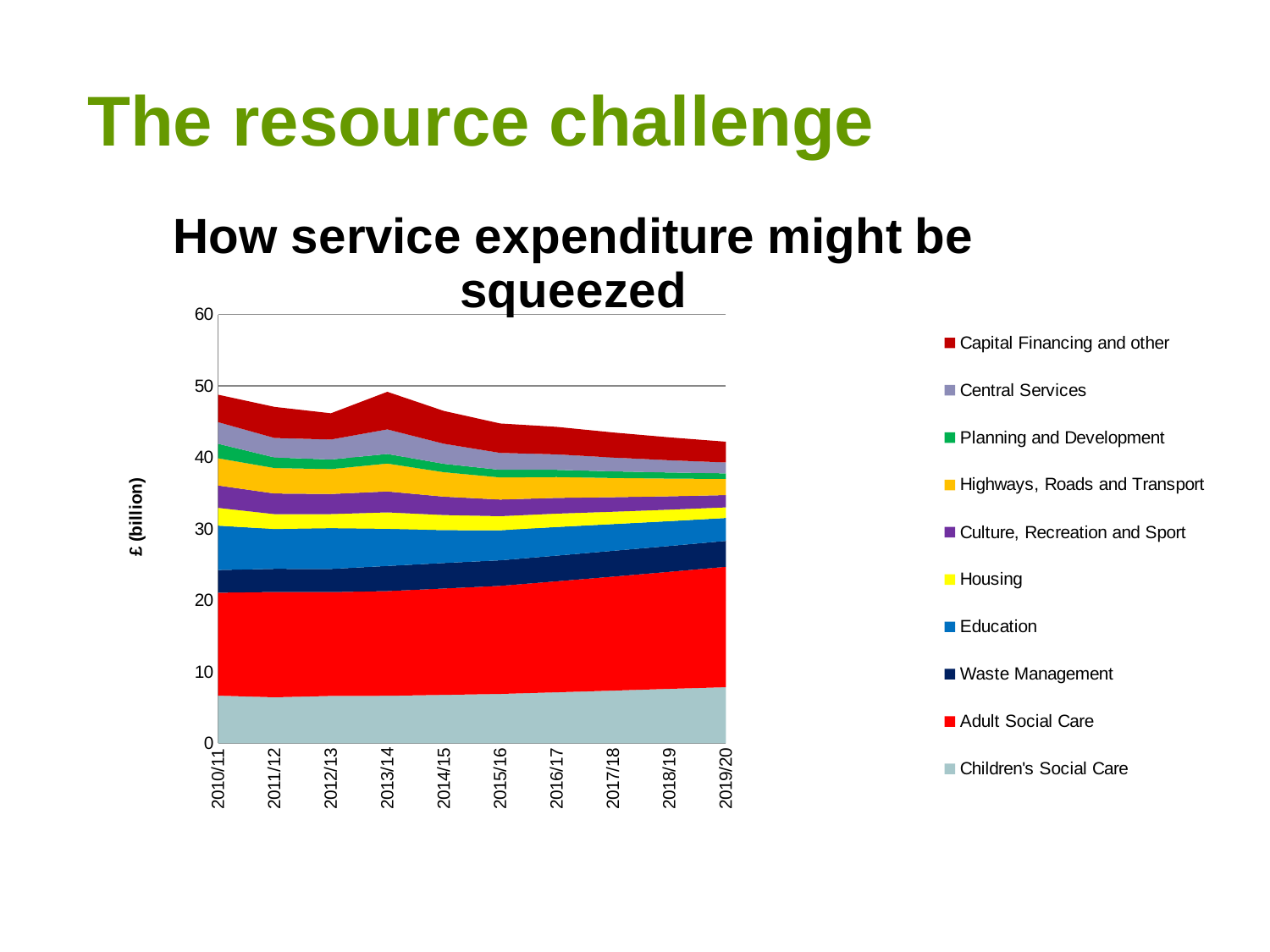
Is the total stacked value for 2019/20 greater or less than 50? less How many series does the legend list? 10 Which is larger in 2019/20, the Adult Social Care band or the Children's Social Care band? Adult Social Care Which series occupies the largest band in the chart? Adult Social Care Does the total stacked expenditure rise or fall from 2010/11 to 2019/20? Fall What type of chart is shown on the slide? Stacked area chart Which year has the highest total stacked expenditure? 2013/14 What is the title of the chart? How service expenditure might be squeezed Is the value for Children's Social Care in 2010/11 greater or less than 10? less What is the label on the y axis? £ (billion) How many years are shown along the x axis? 10 Is the total stacked value for 2010/11 greater or less than 40? greater